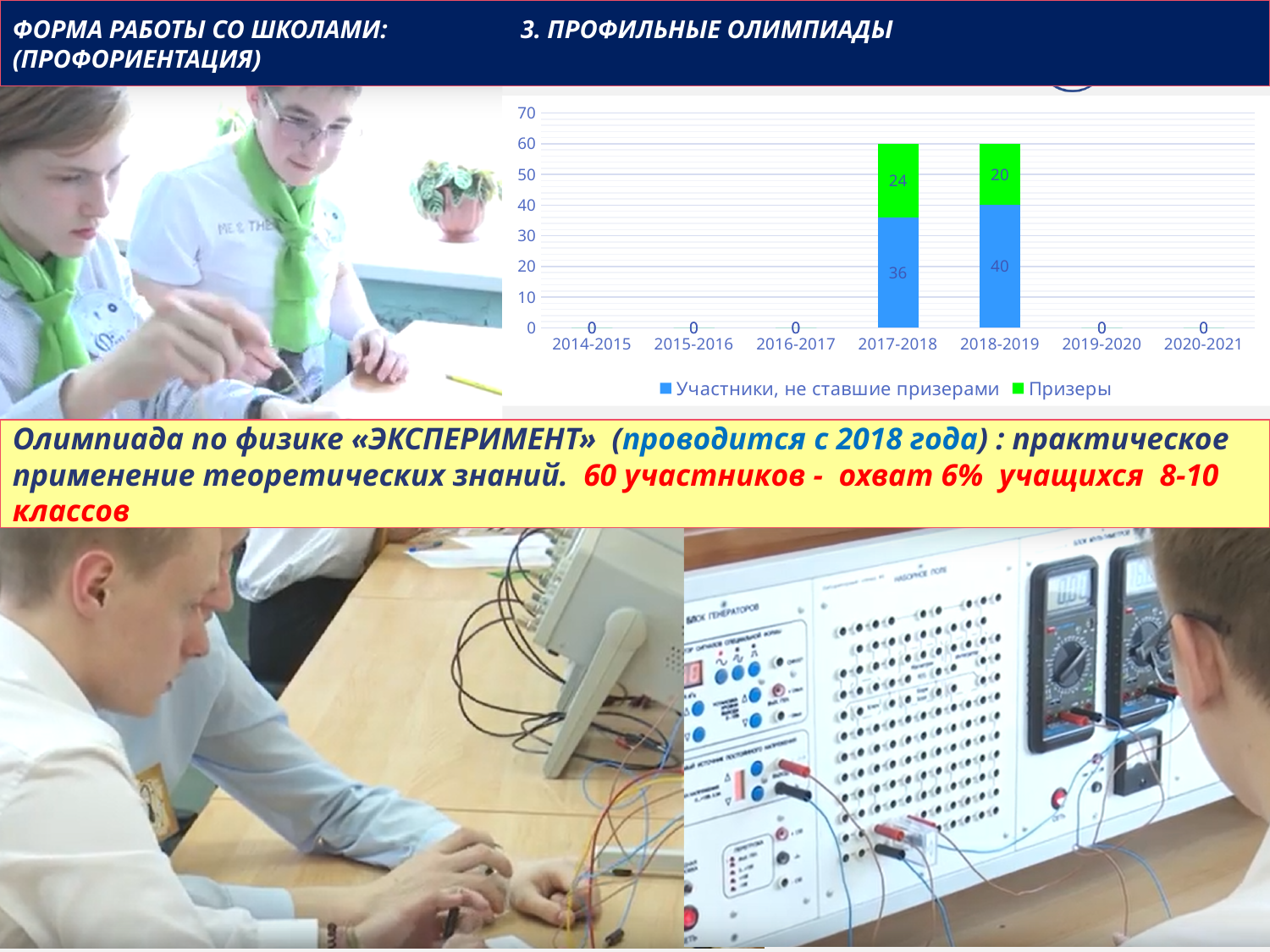
What is the total height of the stacked bar for 2018-2019? 60 How many year categories are shown on the x axis of the chart? 7 How many series does the chart legend list? 2 What is the value of «Участники, не ставшие призерами» for 2018-2019? 40 Which year has the highest value for «Призеры»? 2017-2018 What is the value of «Участники, не ставшие призерами» for 2017-2018? 36 What is the value of «Призеры» for 2018-2019? 20 Which series is shown in green in the chart? Призеры What is the total height of the stacked bar for 2017-2018? 60 What is the difference between the «Участники, не ставшие призерами» values for 2018-2019 and 2017-2018? 4 What kind of chart is shown on the slide? stacked bar chart What is the value of «Призеры» for 2017-2018? 24